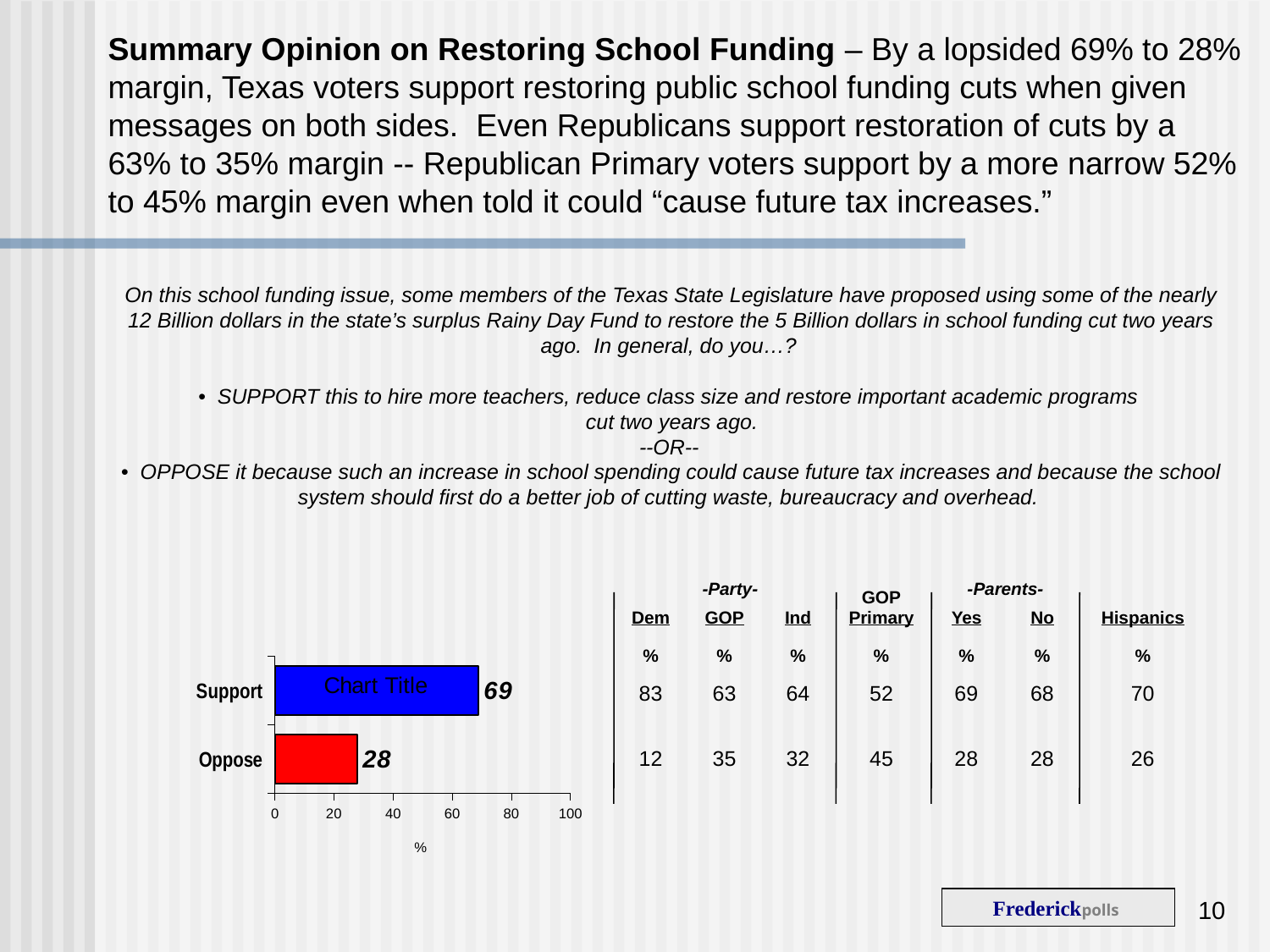
What colour is the Support bar in the chart? blue Which is larger in the bar chart, Support or Oppose? Support Is the value for Oppose greater or less than 40? less What is the difference between the Support and Oppose values in the bar chart? 41 How many categories are shown in the bar chart? 2 Which category has the lowest value in the bar chart? Oppose Which category has the highest value in the bar chart? Support What is the value for Oppose in the bar chart? 28 What kind of chart is shown on the slide? bar chart What is the value for Support in the bar chart? 69 Is the value for Support greater or less than 60? greater What is the highest tick value shown on the chart's horizontal axis? 100